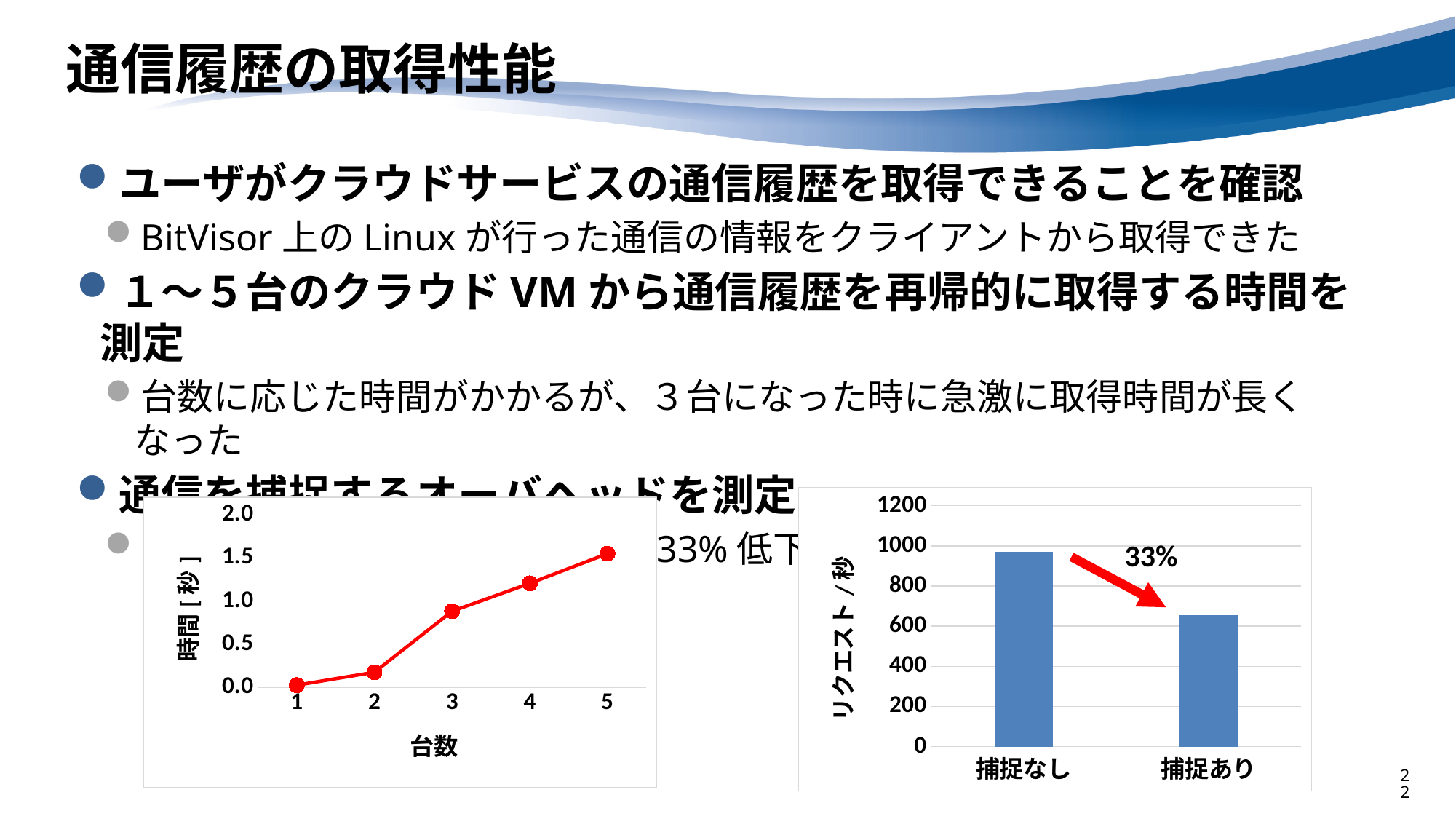
In the right chart, what percentage is written next to the red arrow? 33% In the left chart, which 台数 value has the highest 時間? 5 In the right chart, how many bars are there? 2 In the right chart, which bar is taller, 捕捉なし or 捕捉あり? 捕捉なし In the left chart, how many data points are plotted? 5 What kind of chart is the right chart (リクエスト/秒)? bar chart In the left chart, is the value for 台数 5 greater or less than 2.0? less In the right chart, is the value for 捕捉あり greater or less than 800? less In the left chart, is the value for 台数 3 greater or less than 0.5? greater In the left chart, do the values rise or fall as 台数 increases from 1 to 5? rise In the left chart, which 台数 value has the lowest 時間? 1 What kind of chart is the left chart (時間 vs 台数)? line chart